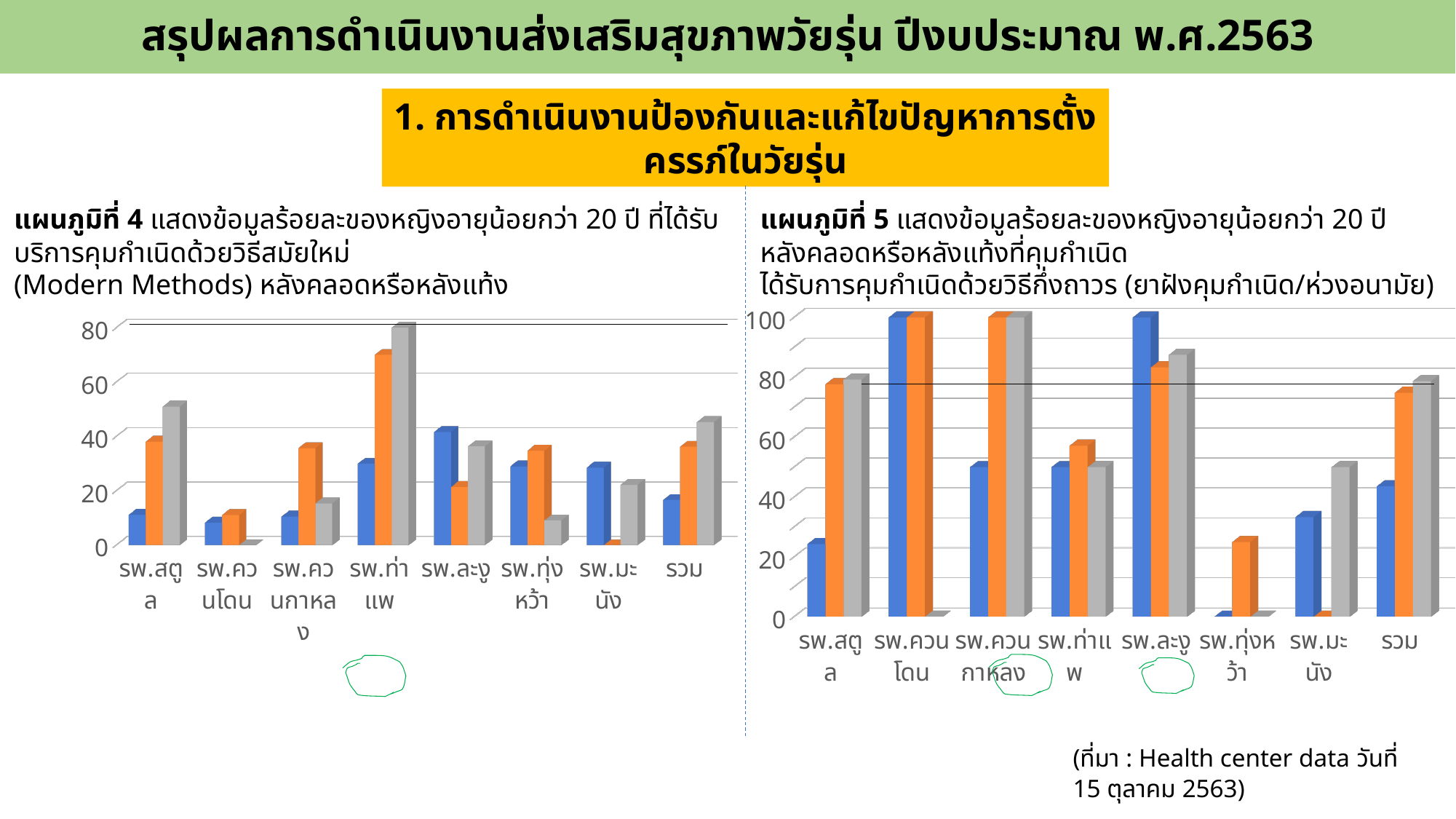
In the left chart (แผนภูมิที่ 4), is the orange bar for รพ.ควนโดน greater or less than 20? less In the left chart (แผนภูมิที่ 4), is the gray bar for รพ.สตูล greater or less than 40? greater What kind of chart is the left chart (แผนภูมิที่ 4)? bar chart How many categories are shown on the x axis of the left chart (แผนภูมิที่ 4)? 8 In the left chart (แผนภูมิที่ 4), which is larger: the orange bar for รพ.ท่าแพ or the orange bar for รพ.สตูล? รพ.ท่าแพ In the right chart (แผนภูมิที่ 5), is the blue bar for รพ.สตูล greater or less than 40? less In the right chart (แผนภูมิที่ 5), which is larger: the blue bar for รพ.ละงู or the blue bar for รพ.สตูล? รพ.ละงู What is the maximum value shown on the y axis of the right chart (แผนภูมิที่ 5)? 100 In the left chart (แผนภูมิที่ 4), which category has the tallest bar overall? รพ.ท่าแพ How many categories are shown on the x axis of the right chart (แผนภูมิที่ 5)? 8